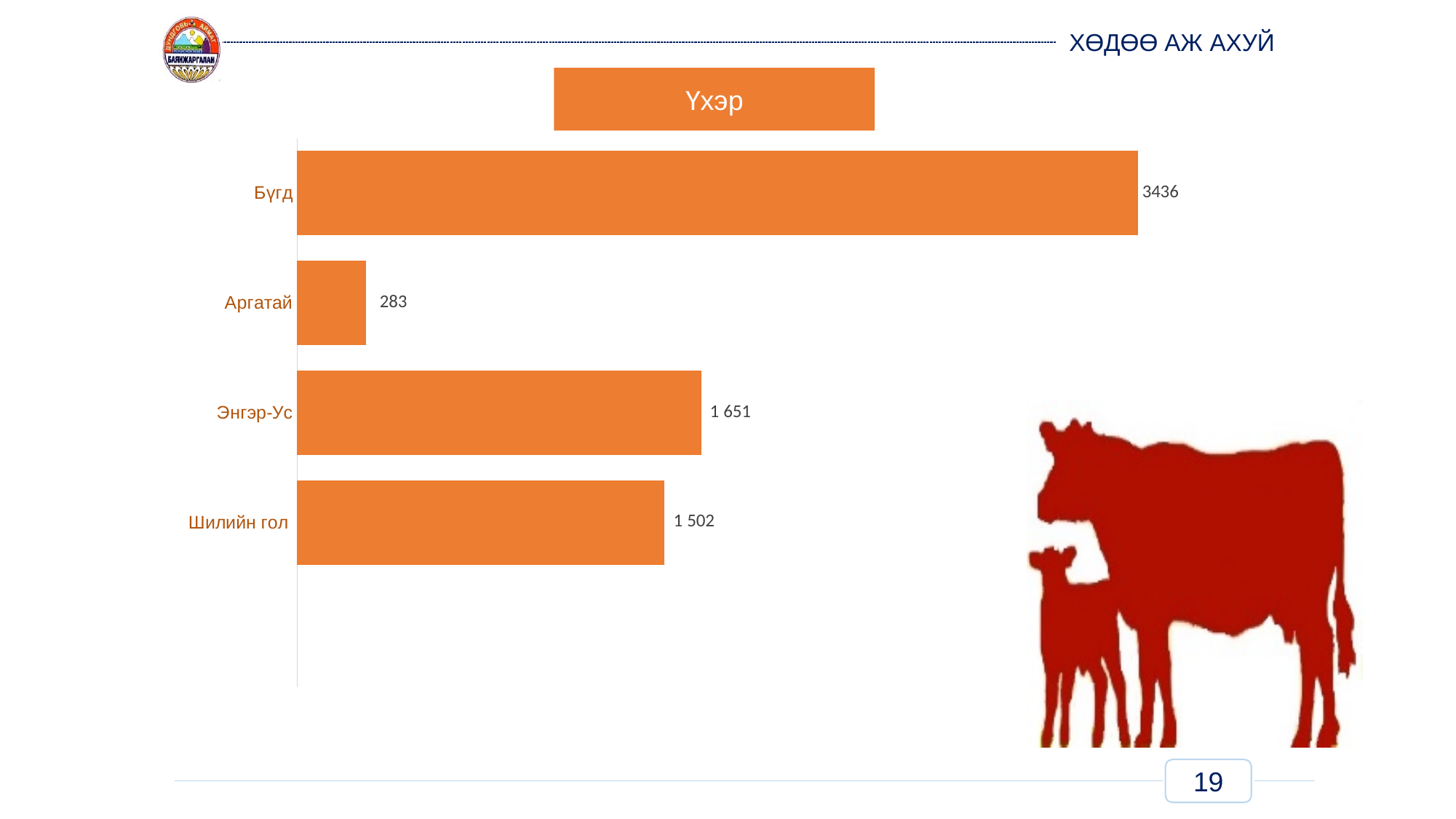
Which category has the highest value? Бүгд What kind of chart is shown on the slide? Bar chart What is the difference between the values for Энгэр-Ус and Аргатай? 1 368 Which is larger, the value for Энгэр-Ус or the value for Шилийн гол? Энгэр-Ус What is the value for Бүгд? 3436 What is the title of the chart? Үхэр How many categories are shown in the chart? 4 What is the value for Шилийн гол? 1 502 What is the difference between the values for Энгэр-Ус and Шилийн гол? 149 What is the value for Энгэр-Ус? 1 651 What is the value for Аргатай? 283 Which category has the lowest value? Аргатай